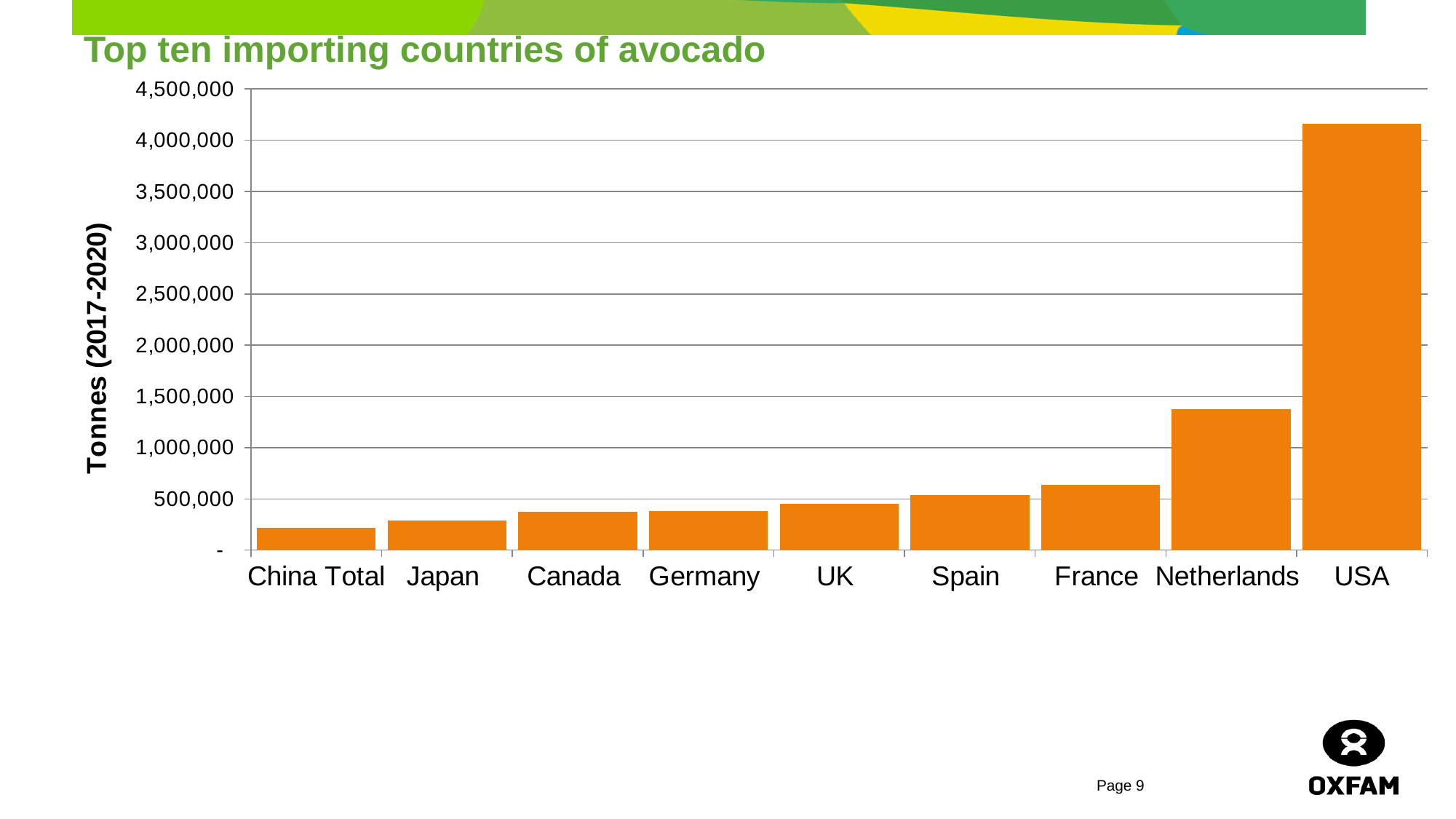
What is the title of the vertical axis? Tonnes (2017-2020) Do the bar values rise or fall from left to right along the x axis? rise Is the value for USA greater or less than 4,000,000? greater Is the value for China Total greater or less than 500,000? less Which country has the lowest avocado import value in the chart? China Total Is the value for Netherlands greater or less than 1,000,000? greater How many countries are shown as bars in the chart? 9 What kind of chart is shown on the slide? bar chart Which is larger, the value for Netherlands or the value for France? Netherlands Which is larger, the value for Japan or the value for France? France Which country has the highest avocado import value in the chart? USA